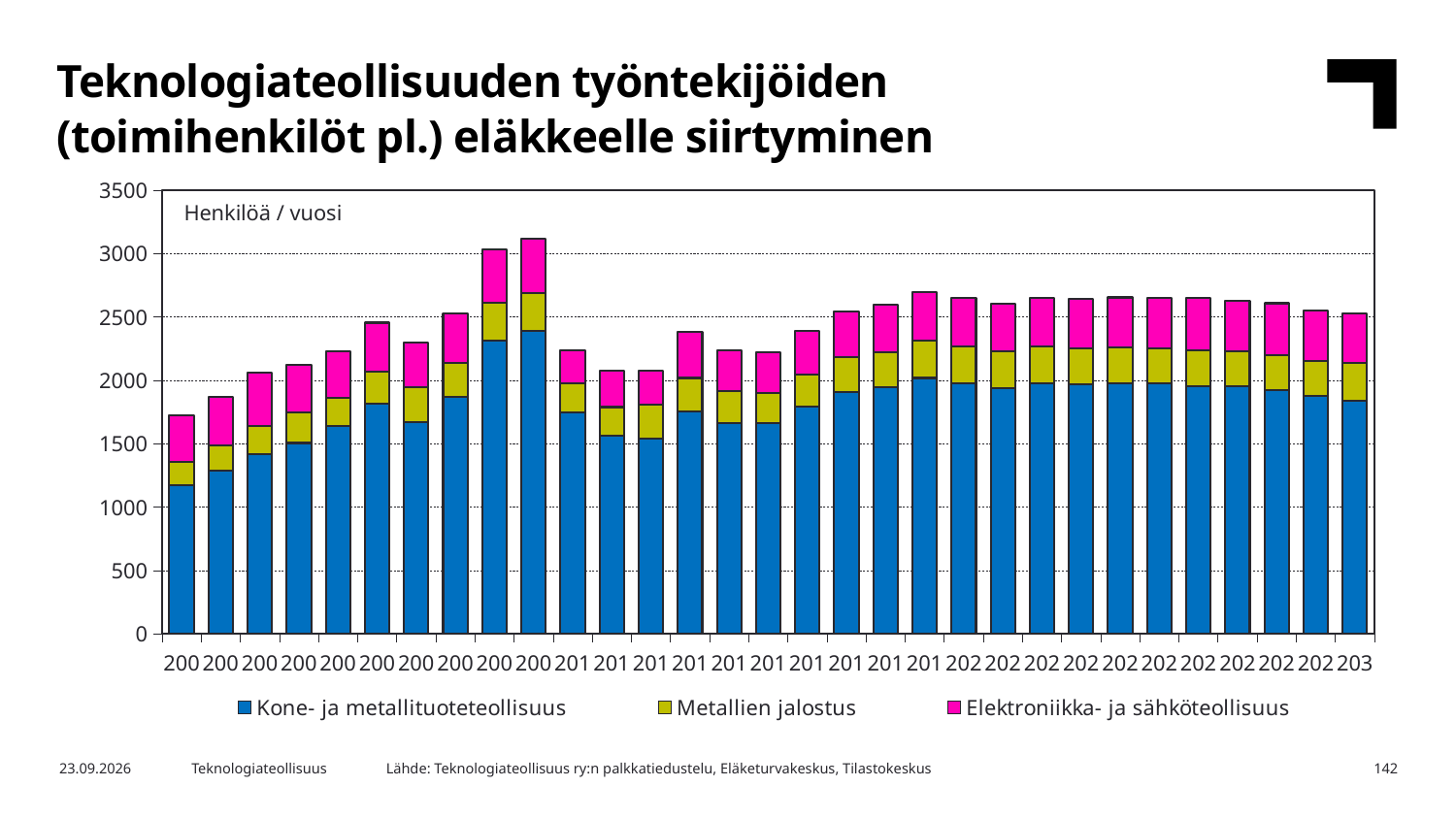
Is the tallest bar located in the left half or the right half of the chart? Left half Comparing the leftmost bar with the rightmost bar, which has the larger total? The rightmost bar What unit label is printed inside the plot area? Henkilöä / vuosi Is the total of the tallest bar greater or less than 3000? greater How many series does the legend list? 3 Is the total of the leftmost bar greater or less than 2000? less Which series forms the smallest segment in the leftmost bar? Metallien jalostus What kind of chart is shown on the slide? Stacked bar chart How many stacked bars are plotted in the chart? 31 Which series forms the largest segment in every bar? Kone- ja metallituoteteollisuus Is the total of the leftmost bar greater or less than 1500? greater What are the three series named in the legend? Kone- ja metallituoteteollisuus, Metallien jalostus, Elektroniikka- ja sähköteollisuus